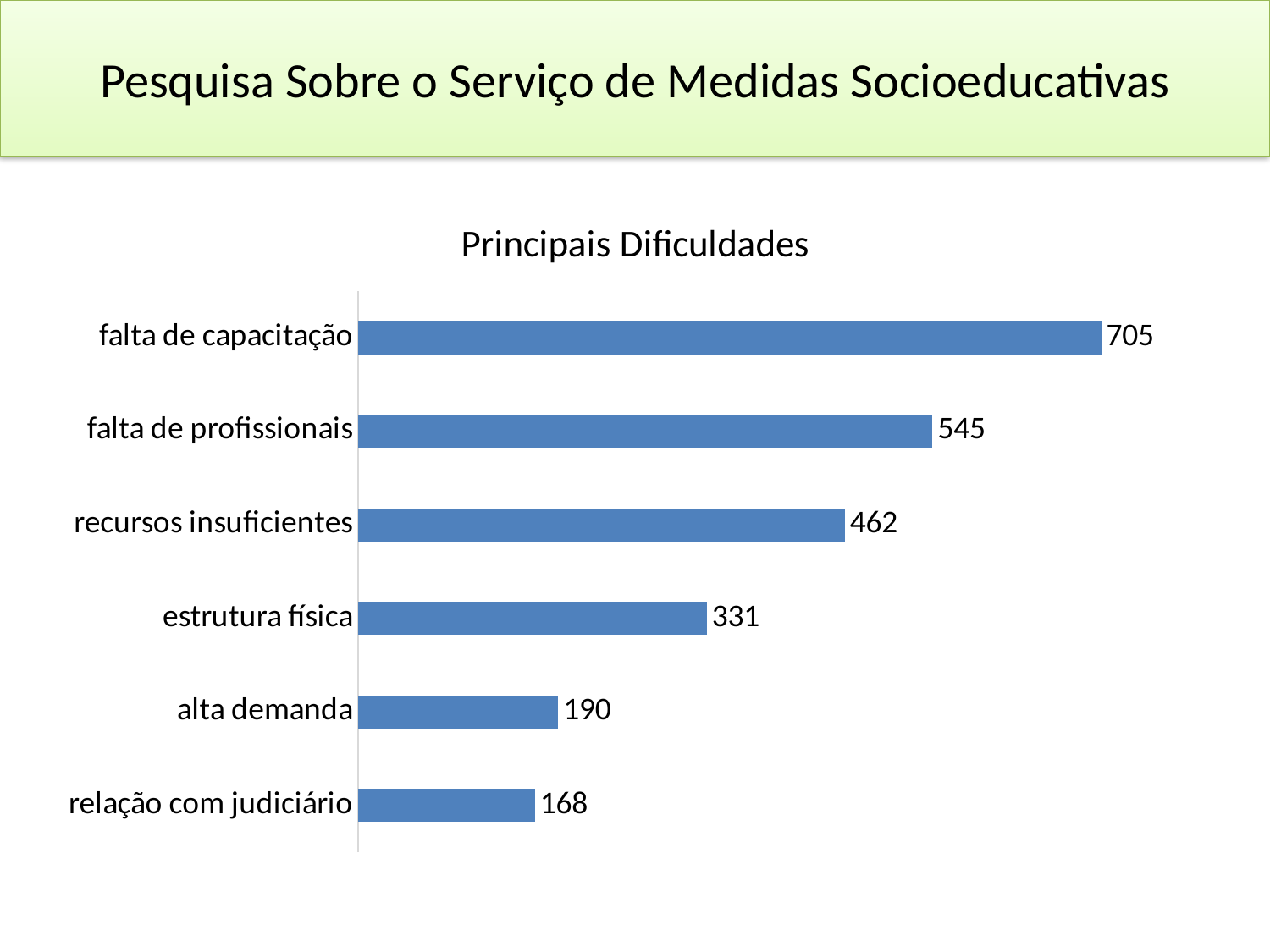
Which category has the lowest value? relação com judiciário What is the value for "estrutura física"? 331 What kind of chart is shown on the slide? bar chart What is the value for "relação com judiciário"? 168 Which is larger, the value for "alta demanda" or the value for "relação com judiciário"? alta demanda Which category has the highest value? falta de capacitação What is the value for "alta demanda"? 190 What is the difference between the values for "recursos insuficientes" and "estrutura física"? 131 What is the difference between the values for "falta de capacitação" and "falta de profissionais"? 160 What is the title of the chart? Principais Dificuldades What is the value for "falta de capacitação"? 705 How many categories are shown in the chart? 6